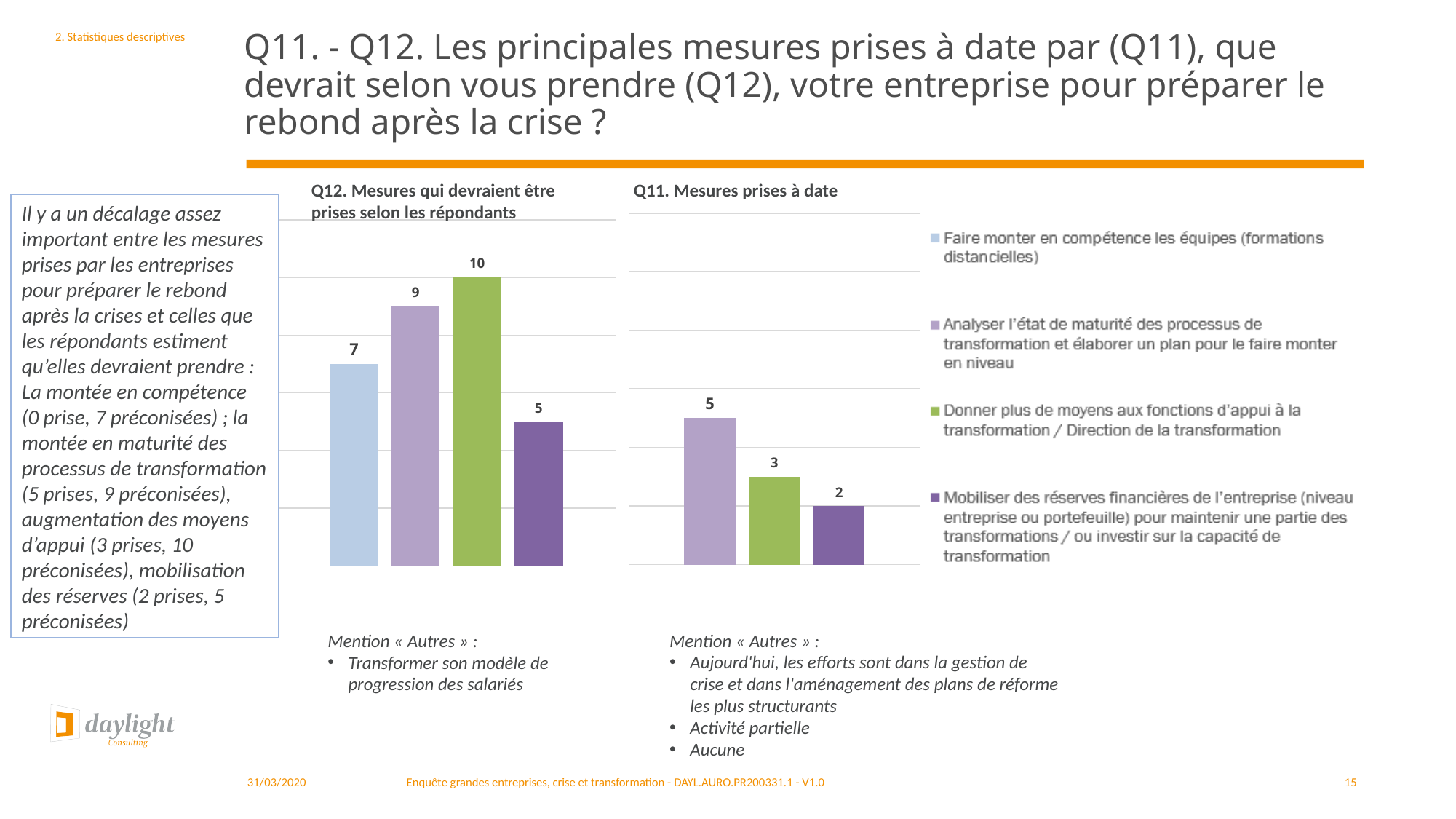
In the chart 'Q11. Mesures prises à date', what is the value for 'Mobiliser des réserves financières de l'entreprise'? 2 In the chart 'Q12. Mesures qui devraient être prises selon les répondants', what is the difference between the value for 'Donner plus de moyens aux fonctions d'appui' and the value for 'Mobiliser des réserves financières'? 5 In the chart 'Q12. Mesures qui devraient être prises selon les répondants', which measure has the highest value? Donner plus de moyens aux fonctions d'appui à la transformation / Direction de la transformation In the chart 'Q11. Mesures prises à date', which measure has the highest value? Analyser l'état de maturité des processus de transformation et élaborer un plan pour le faire monter en niveau In the chart 'Q12. Mesures qui devraient être prises selon les répondants', what is the value for 'Donner plus de moyens aux fonctions d'appui à la transformation / Direction de la transformation'? 10 What kind of chart is 'Q11. Mesures prises à date'? Bar chart In the chart 'Q11. Mesures prises à date', what is the value for 'Analyser l'état de maturité des processus de transformation et élaborer un plan pour le faire monter en niveau'? 5 In the chart 'Q11. Mesures prises à date', what is the difference between the value for 'Analyser l'état de maturité des processus de transformation' and the value for 'Donner plus de moyens aux fonctions d'appui'? 2 In the chart 'Q12. Mesures qui devraient être prises selon les répondants', what is the value for 'Faire monter en compétence les équipes (formations distancielles)'? 7 Which is larger: the value for 'Analyser l'état de maturité des processus de transformation' in the Q12 chart or in the Q11 chart? Q12 chart In the chart 'Q12. Mesures qui devraient être prises selon les répondants', which measure has the lowest value? Mobiliser des réserves financières de l'entreprise How many entries does the shared legend list? 4